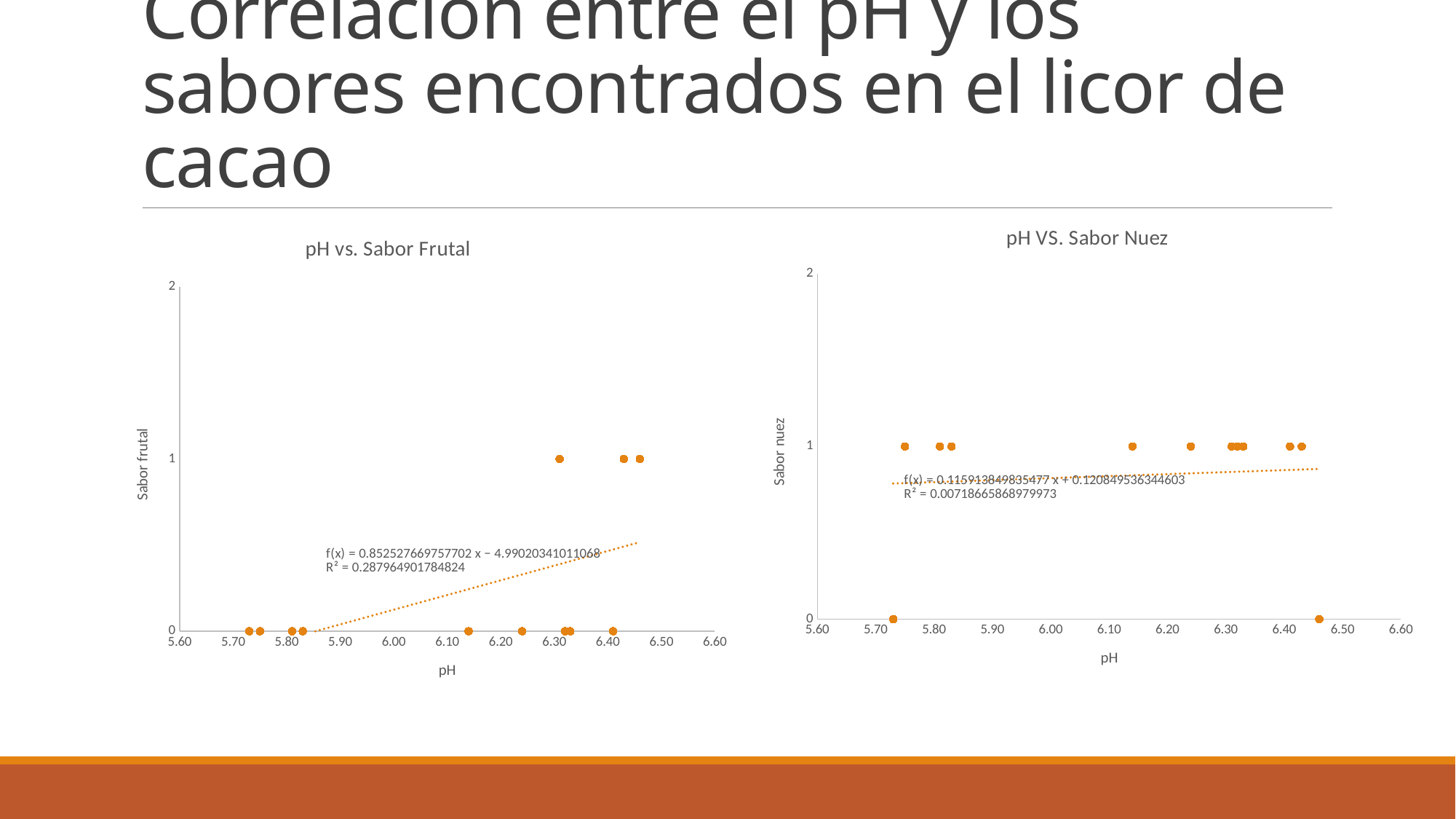
In the 'pH vs. Sabor Frutal' chart, how many points have a Sabor frutal value of 1? 3 What kind of chart is the 'pH vs. Sabor Frutal' chart on the left? scatter chart In the 'pH vs. Sabor Frutal' chart, what is the R² value shown for the trendline? R² = 0.287964901784824 In the 'pH VS. Sabor Nuez' chart, how many points have a Sabor nuez value of 0? 2 Which chart has the larger R² value, 'pH vs. Sabor Frutal' or 'pH VS. Sabor Nuez'? pH vs. Sabor Frutal In the 'pH VS. Sabor Nuez' chart, what is the trendline equation displayed? f(x) = 0.115913849835477 x + 0.120849536344603 In the 'pH vs. Sabor Frutal' chart, what is the highest Sabor frutal value reached by any point? 1 In the 'pH VS. Sabor Nuez' chart, what is the label of the x axis? pH What is the title of the chart on the right side of the slide? pH VS. Sabor Nuez In the 'pH vs. Sabor Frutal' chart, what is the trendline equation displayed? f(x) = 0.852527669757702 x − 4.99020341011068 In the 'pH VS. Sabor Nuez' chart, what is the R² value shown for the trendline? R² = 0.00718665868979973 In the 'pH vs. Sabor Frutal' chart, does the dotted trendline rise or fall as pH increases? rise